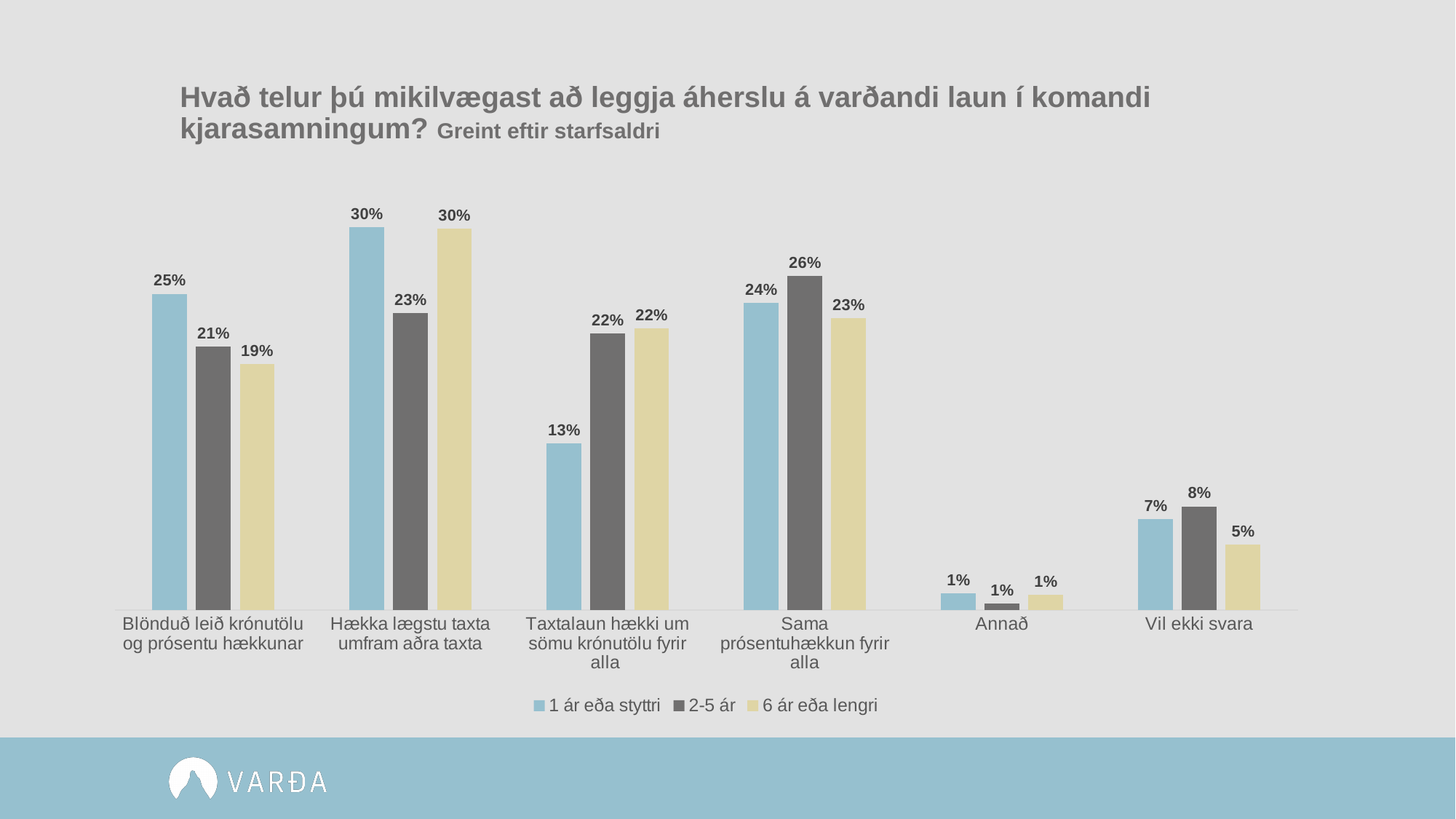
Which category has the highest value for the "1 ár eða styttri" series? Hækka lægstu taxta umfram aðra taxta What is the difference between the "1 ár eða styttri" and "2-5 ár" values in the "Taxtalaun hækki um sömu krónutölu fyrir alla" category? 9% How many categories are shown on the x axis? 6 In the "Blönduð leið krónutölu og prósentu hækkunar" category, which is larger: the value for "2-5 ár" or for "6 ár eða lengri"? 2-5 ár What is the value for "1 ár eða styttri" in the "Blönduð leið krónutölu og prósentu hækkunar" category? 25% What is the total of the three series values in the "Vil ekki svara" category? 20% Which series is shown in yellow in the legend? 6 ár eða lengri Which category has the lowest value for the "2-5 ár" series? Annað How many series does the legend list? 3 What kind of chart is shown on the slide? Bar chart What is the value for "6 ár eða lengri" in the "Vil ekki svara" category? 5% What is the value for "2-5 ár" in the "Sama prósentuhækkun fyrir alla" category? 26%